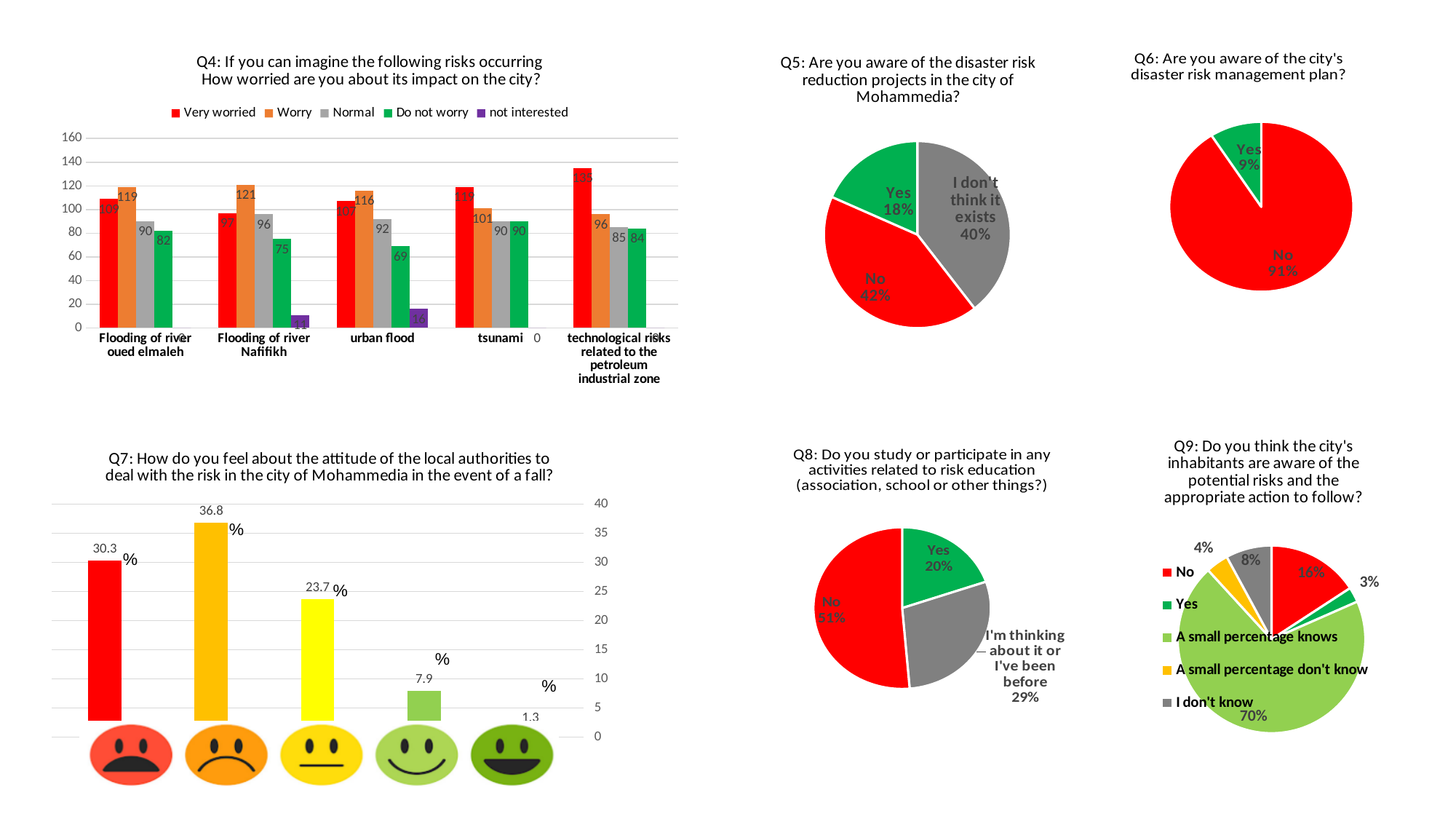
In the Q4 chart, how many risk categories are shown on the x axis? 5 In the Q4 chart, what is the 'Very worried' value for technological risks related to the petroleum industrial zone? 135 In the Q4 chart, what is the difference between the 'Worry' and 'Do not worry' values for urban flood? 47 In the Q5 pie chart, what share of respondents answered 'I don't think it exists'? 40% In the Q8 pie chart, what share answered 'I'm thinking about it or I've been before'? 29% In the Q9 pie chart, which answer has the largest share? A small percentage knows In the Q4 chart, what is the 'Worry' value for Flooding of river Nafifikh? 121 In the Q6 pie chart, what percentage answered 'No'? 91% In the Q4 chart, which category has the highest 'Very worried' value? technological risks related to the petroleum industrial zone What kind of chart is used for Q7? bar chart In the Q7 chart, what is the highest value shown? 36.8 In the Q4 chart, how many series does the legend list? 5